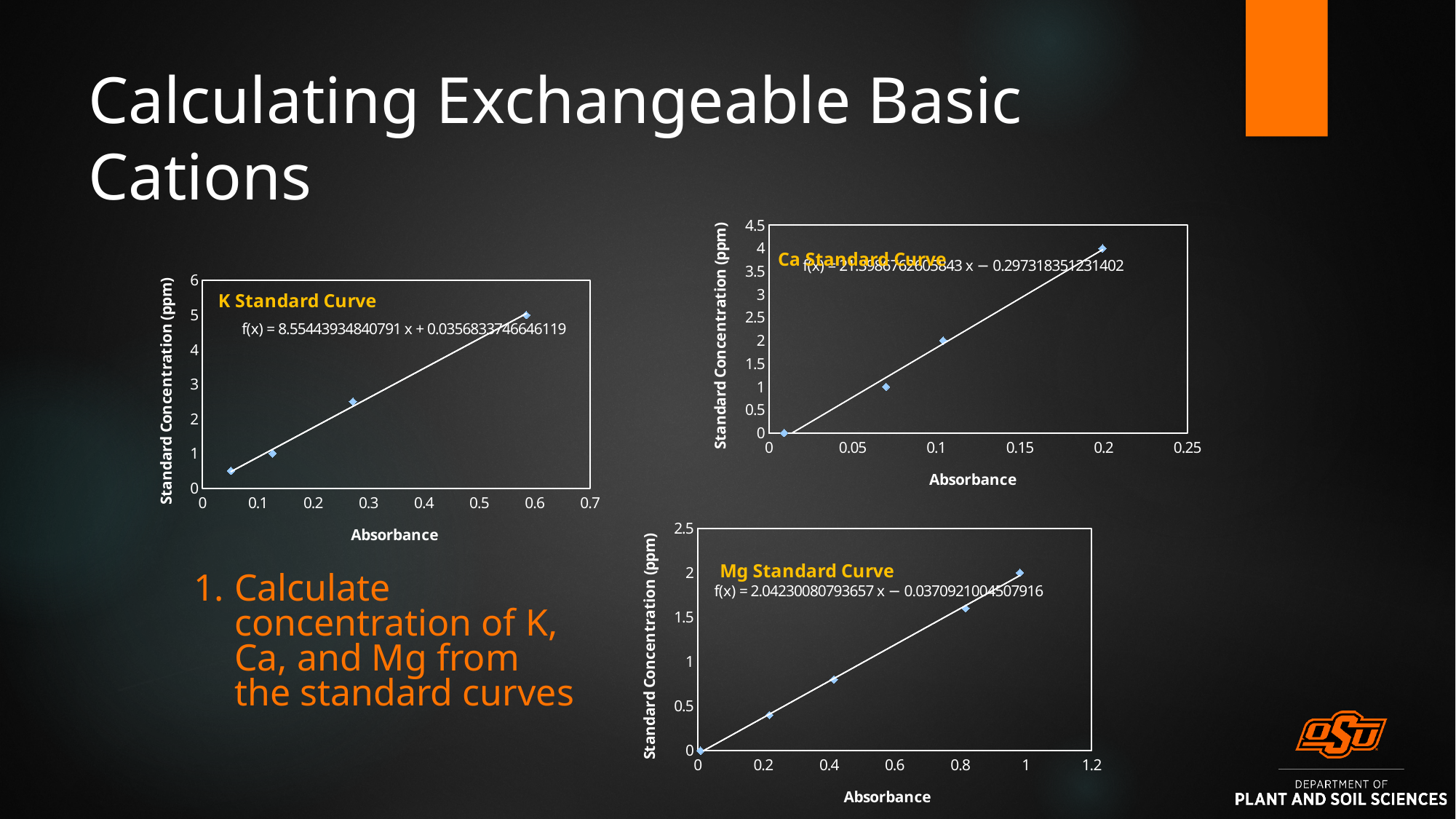
On the Mg Standard Curve, does standard concentration rise or fall as absorbance increases? Rise On the Ca Standard Curve, is the standard concentration of the highest point greater or less than 3.5 ppm? greater How many data points are plotted on the K Standard Curve? 4 What kind of chart is the K Standard Curve? Scatter chart How many data points are plotted on the Mg Standard Curve? 5 How many data points are plotted on the Ca Standard Curve? 4 What is the x-axis label on the Mg Standard Curve? Absorbance On the Ca Standard Curve, does standard concentration rise or fall as absorbance increases? Rise What is the y-axis label on the K Standard Curve? Standard Concentration (ppm) On the K Standard Curve, is the standard concentration of the highest point greater or less than 4 ppm? greater On the Mg Standard Curve, is the absorbance of the highest point greater or less than 0.8? greater